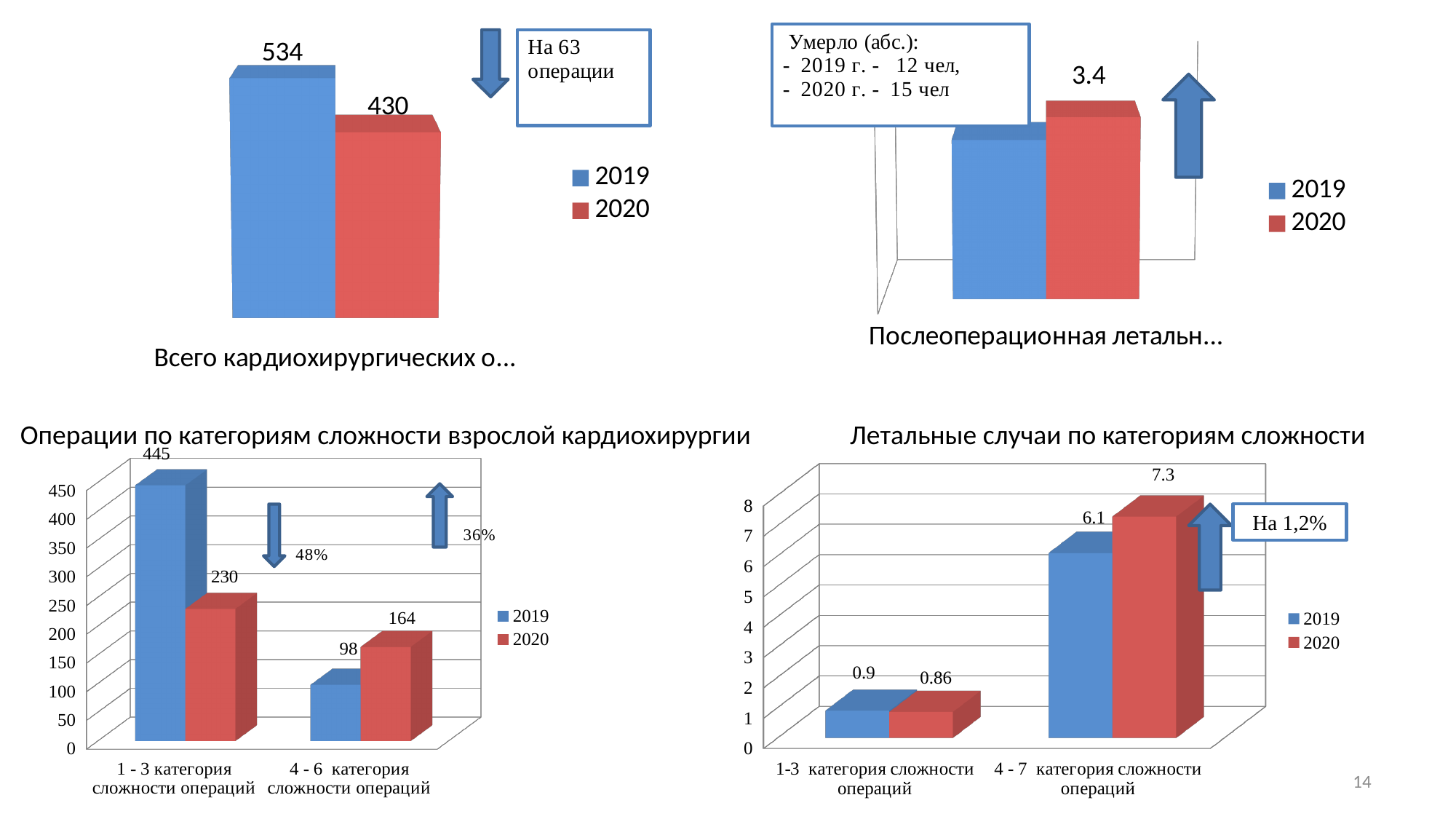
How many series does the legend of the bottom-right chart (Летальные случаи по категориям сложности) list? 2 In the bottom-left chart (Операции по категориям сложности взрослой кардиохирургии), which bar is the highest? 2019, 1 - 3 категория сложности операций (445) In the bottom-right chart (Летальные случаи по категориям сложности), what is the 2020 value for 4 - 7 категория сложности операций? 7.3 In the top-left chart (Всего кардиохирургических о...), what is the difference between the 2019 and 2020 values? 104 In the bottom-left chart (Операции по категориям сложности взрослой кардиохирургии), what is the 2020 value for 1 - 3 категория сложности операций? 230 In the bottom-left chart (Операции по категориям сложности взрослой кардиохирургии), what is the 2019 value for 4 - 6 категория сложности операций? 98 In the bottom-left chart (Операции по категориям сложности взрослой кардиохирургии), what is the difference between the 2019 and 2020 values for 1 - 3 категория сложности операций? 215 In the bottom-right chart (Летальные случаи по категориям сложности), what is the 2019 value for 1-3 категория сложности операций? 0.9 In the bottom-right chart (Летальные случаи по категориям сложности), which bar is the lowest? 2020, 1-3 категория сложности операций (0.86) In the top-right chart (Послеоперационная летальн...), what is the value for 2020? 3.4 In the top-right chart (Послеоперационная летальн...), which year has the higher bar, 2019 or 2020? 2020 In the top-left chart (Всего кардиохирургических о...), what is the value for 2019? 534